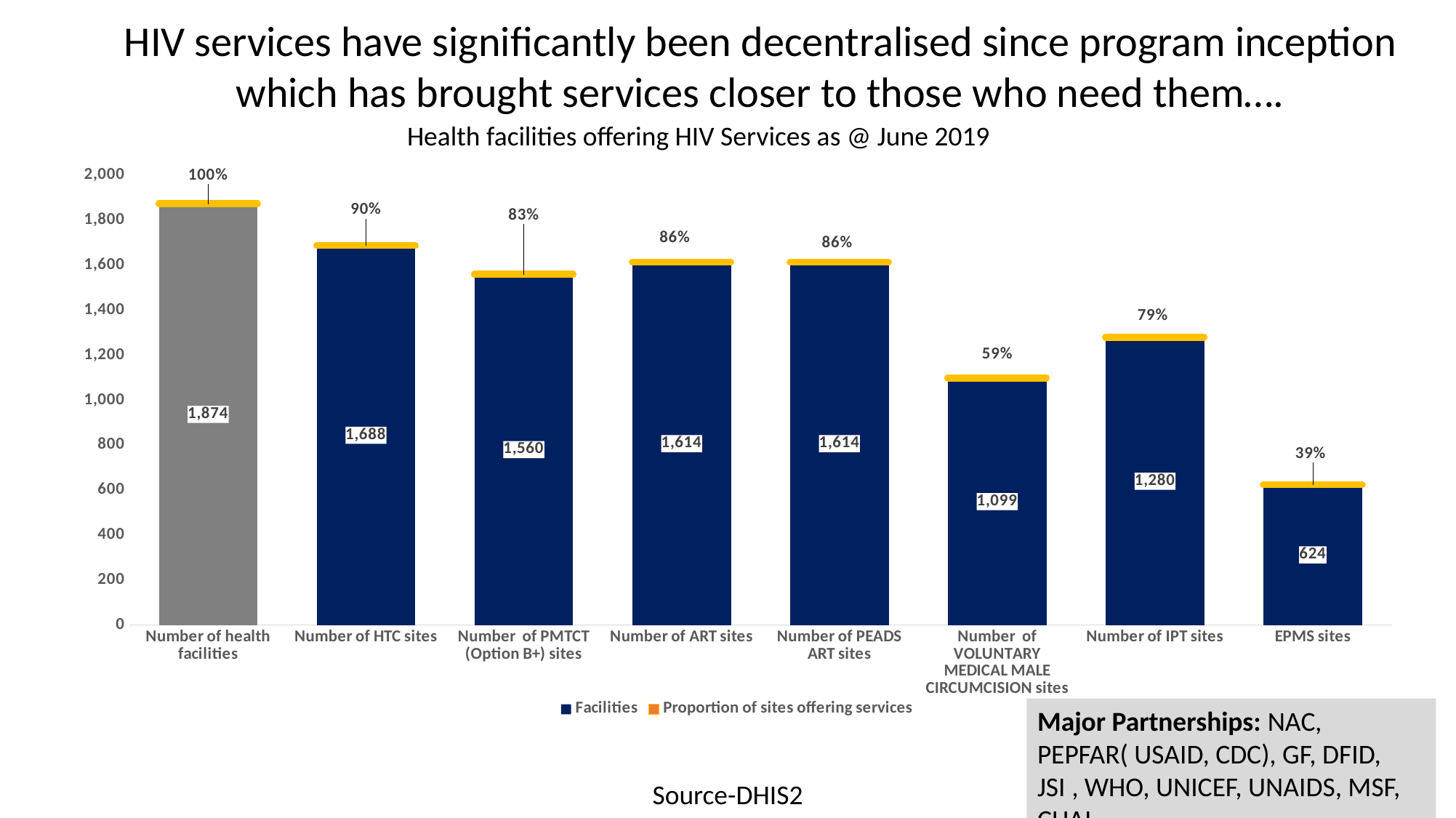
Which category has the lowest number of facilities? EPMS sites How many series does the legend list? 2 How many categories are shown on the x axis? 8 What proportion of sites offer services for EPMS sites? 39% What is the number of HTC sites shown on the chart? 1,688 What kind of chart is shown on the slide? Bar chart What is the title of the chart? Health facilities offering HIV Services as @ June 2019 What is the difference between the number of health facilities and the number of HTC sites? 186 What proportion of sites offer voluntary medical male circumcision services? 59% Which is larger, the number of PMTCT (Option B+) sites or the number of ART sites? Number of ART sites Which category has the highest number of facilities? Number of health facilities What is the number of IPT sites? 1,280